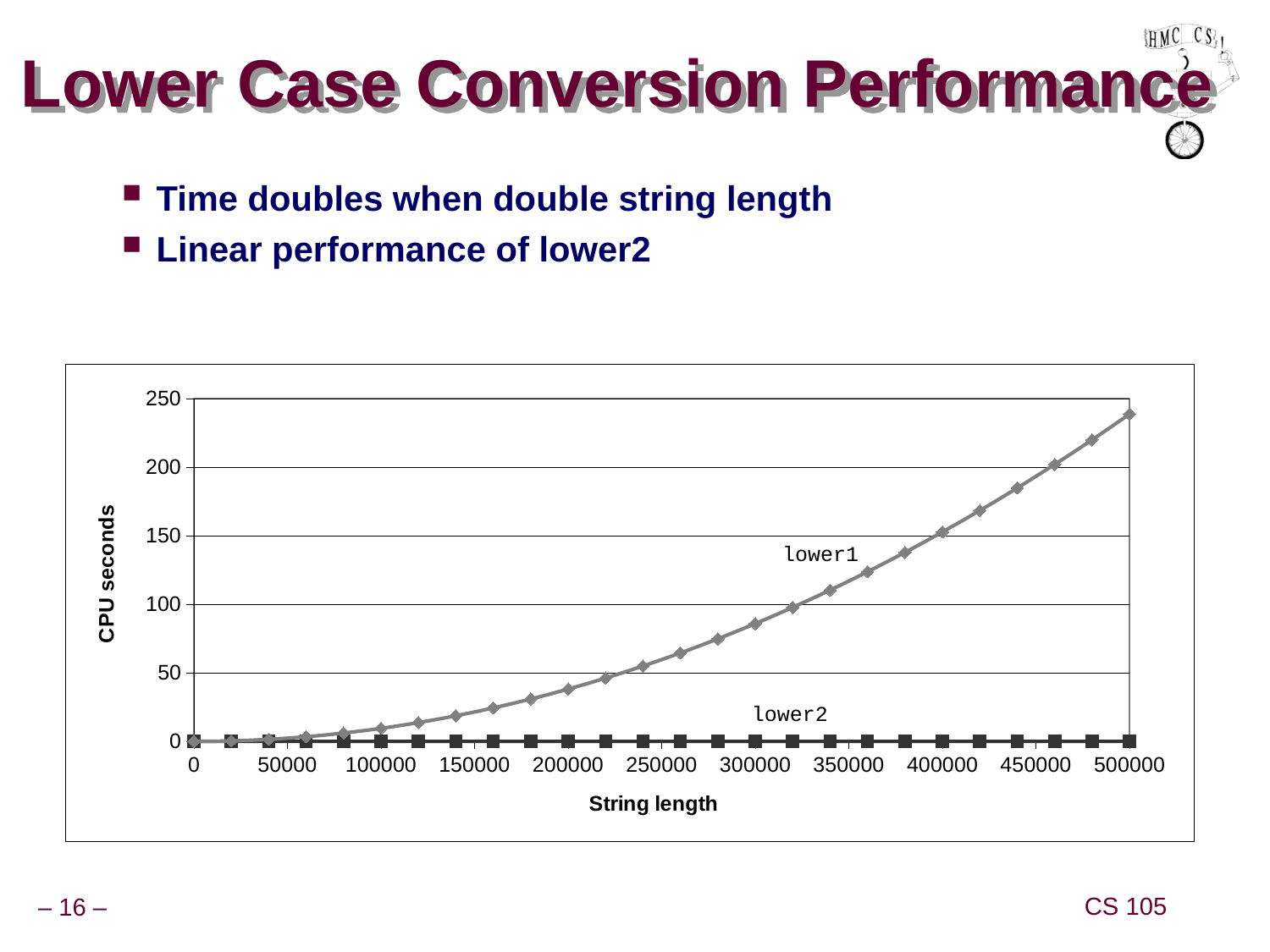
What are the names of the two series plotted on the chart? lower1 and lower2 Does the lower1 series rise or fall as string length increases? rise Is the value for lower1 at string length 300000 greater or less than 100? less Is the value for lower1 at string length 500000 greater or less than 200? greater At string length 500000, which series has the larger value, lower1 or lower2? lower1 At which string length does lower1 reach its highest value? 500000 What kind of chart is shown on the slide? line chart Which series stays lowest across the whole chart? lower2 How many series are plotted on the chart? 2 What is the label of the y axis? CPU seconds Is the value for lower2 at string length 500000 greater or less than 50? less